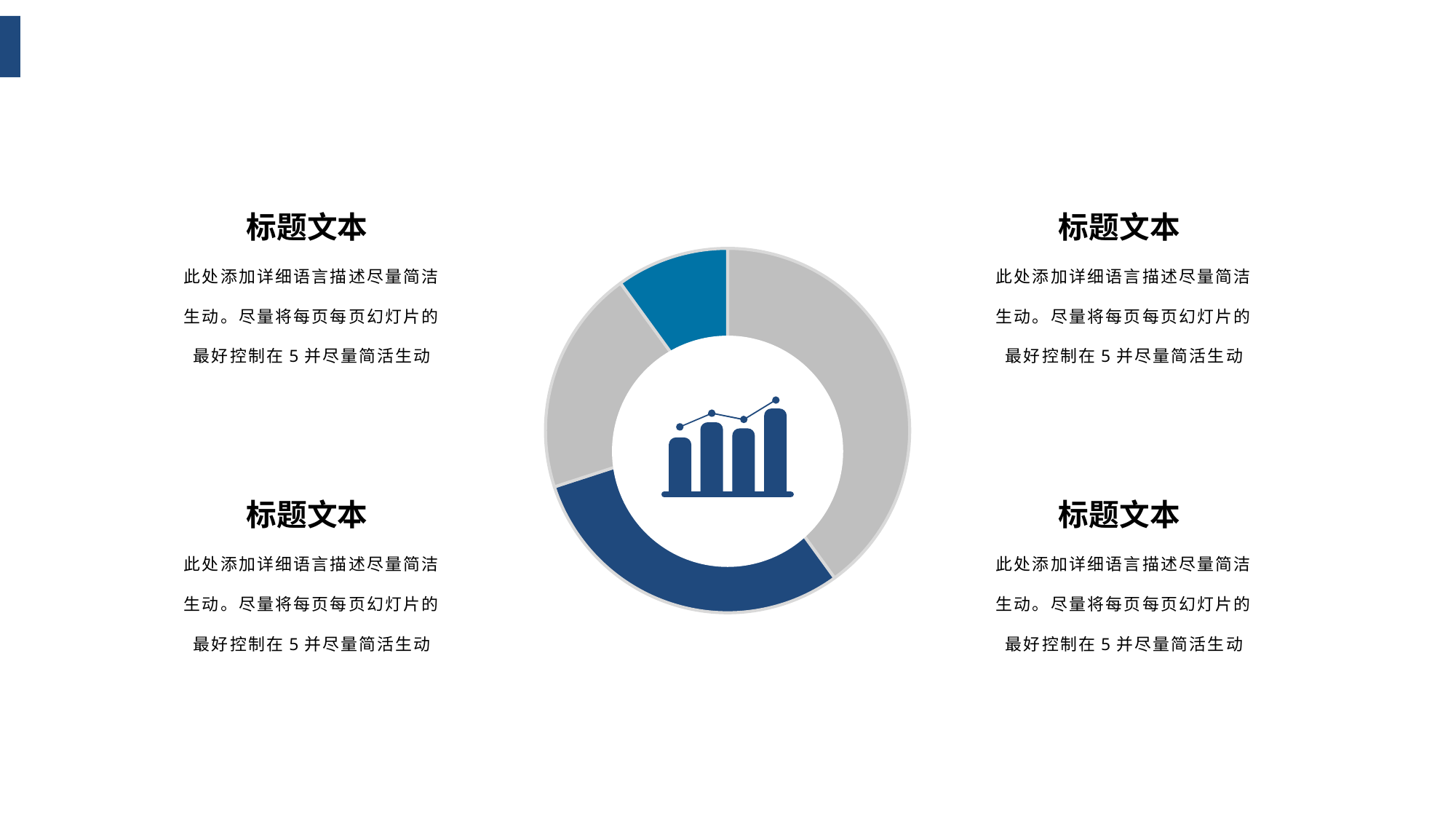
Does the doughnut chart display any data labels or a legend? No What kind of chart is shown in the centre of the slide? Doughnut chart Which segment of the doughnut chart is the smallest? The light blue segment What icon appears in the centre of the doughnut chart? A bar chart with a line graph How many segments does the doughnut chart have? 4